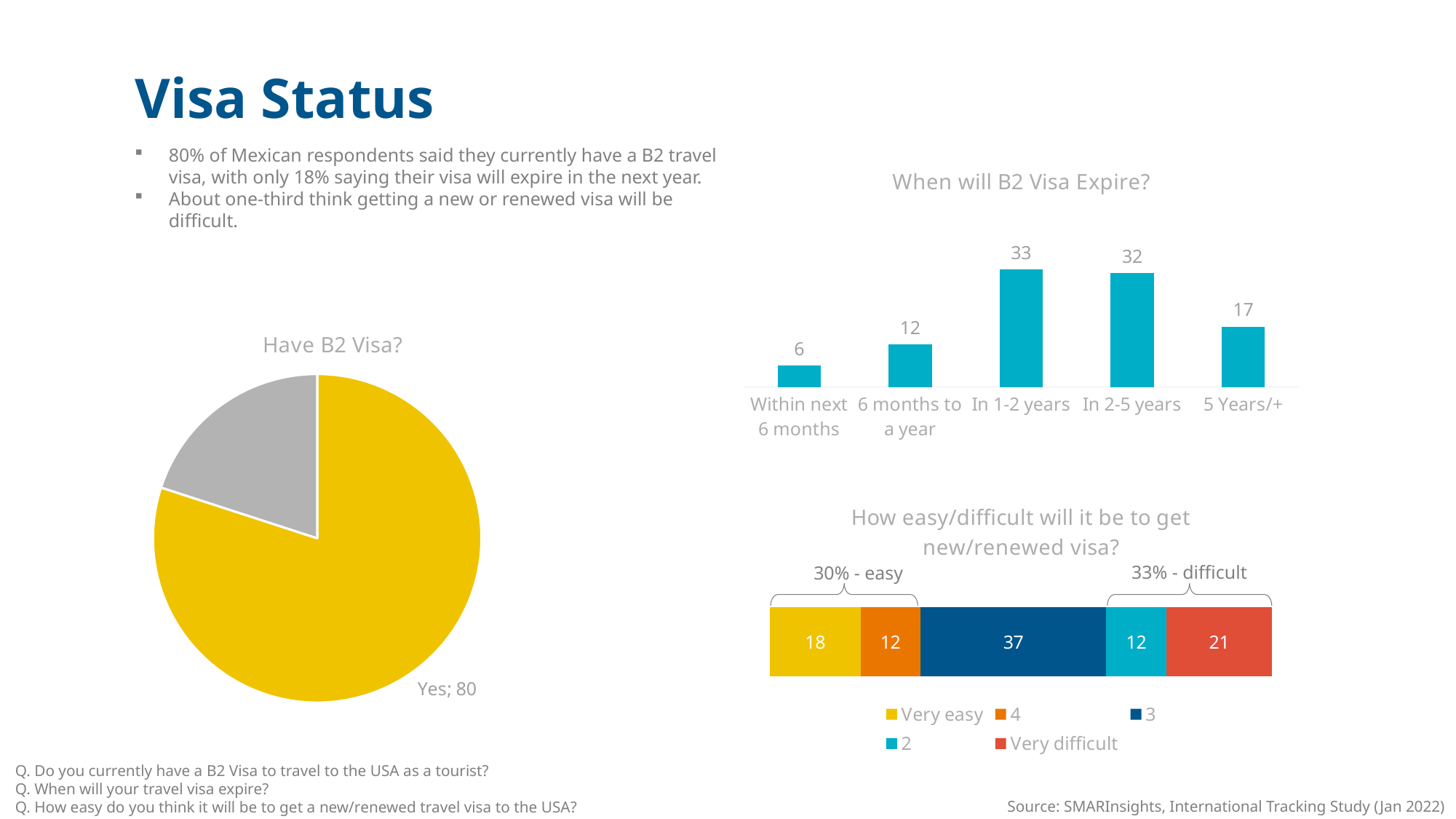
What kind of chart is the 'Have B2 Visa?' chart? pie chart What kind of chart is the 'When will B2 Visa Expire?' chart? bar chart In the 'How easy/difficult will it be to get new/renewed visa?' chart, what is the value for '3'? 37 In the 'When will B2 Visa Expire?' chart, what is the value for '5 Years/+'? 17 In the 'When will B2 Visa Expire?' chart, how many categories are shown? 5 In the 'How easy/difficult will it be to get new/renewed visa?' chart, how many series does the legend list? 5 In the 'When will B2 Visa Expire?' chart, what is the value for 'In 1-2 years'? 33 In the 'How easy/difficult will it be to get new/renewed visa?' chart, what is the total of the stacked bar? 100 In the 'When will B2 Visa Expire?' chart, which category has the lowest value? Within next 6 months In the 'When will B2 Visa Expire?' chart, what is the difference between 'In 2-5 years' and '6 months to a year'? 20 In the 'When will B2 Visa Expire?' chart, which is larger: 'In 2-5 years' or '5 Years/+'? In 2-5 years In the 'Have B2 Visa?' chart, what value is shown for the 'Yes' slice? 80